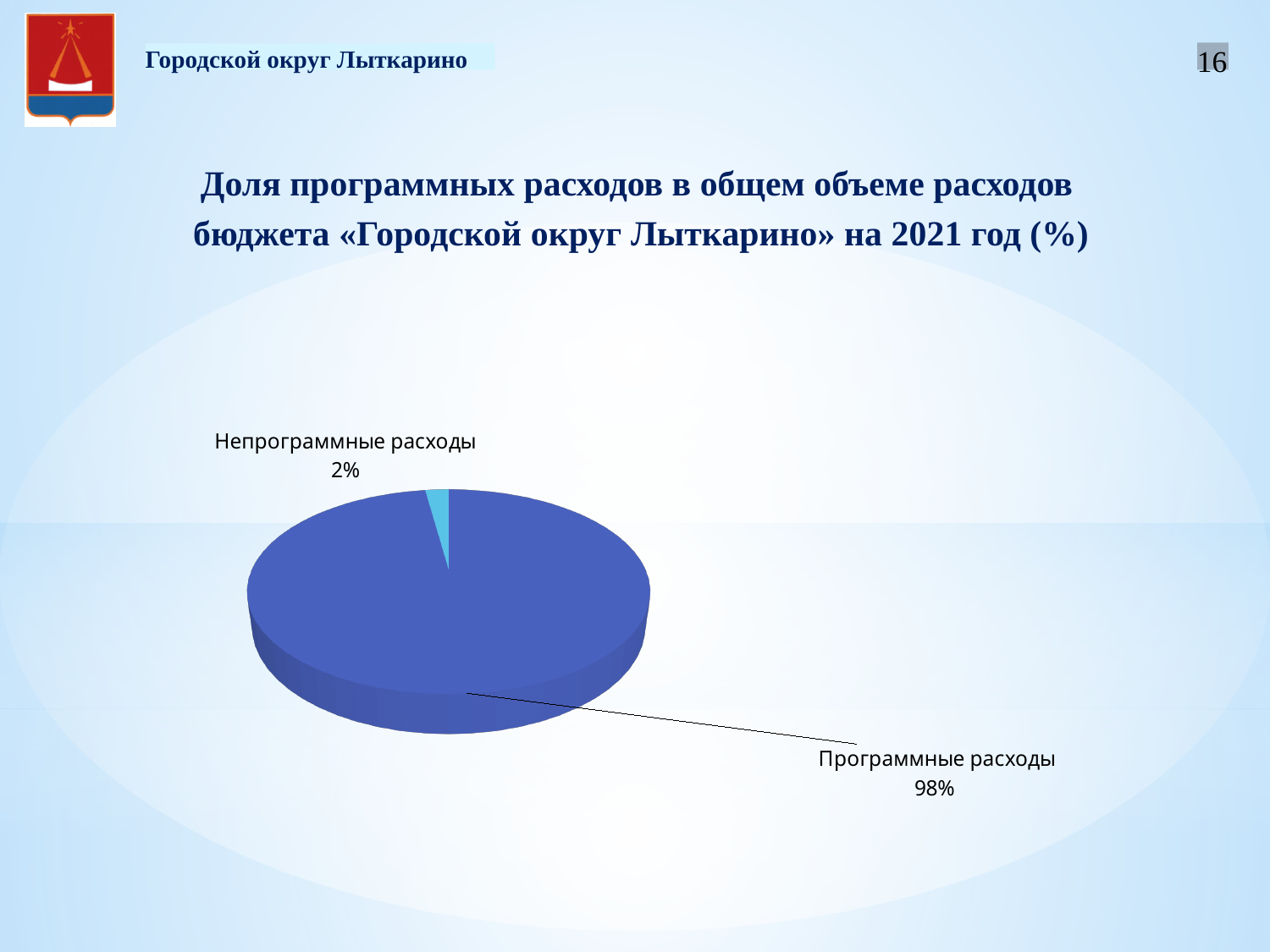
Is the share of «Непрограммные расходы» greater or less than 10%? less What is the total of the two slices shown in the pie chart? 100% Which slice of the pie is the largest? Программные расходы What colour is the «Непрограммные расходы» slice? light blue How many slices does the pie chart have? 2 What kind of chart is shown on the slide? pie chart Which slice of the pie is the smallest? Непрограммные расходы What share of the pie does «Программные расходы» take? 98% What share of the pie does «Непрограммные расходы» take? 2% What year does the chart title refer to? 2021 Which is larger: «Программные расходы» or «Непрограммные расходы»? Программные расходы What is the difference in percentage points between «Программные расходы» and «Непрограммные расходы»? 96